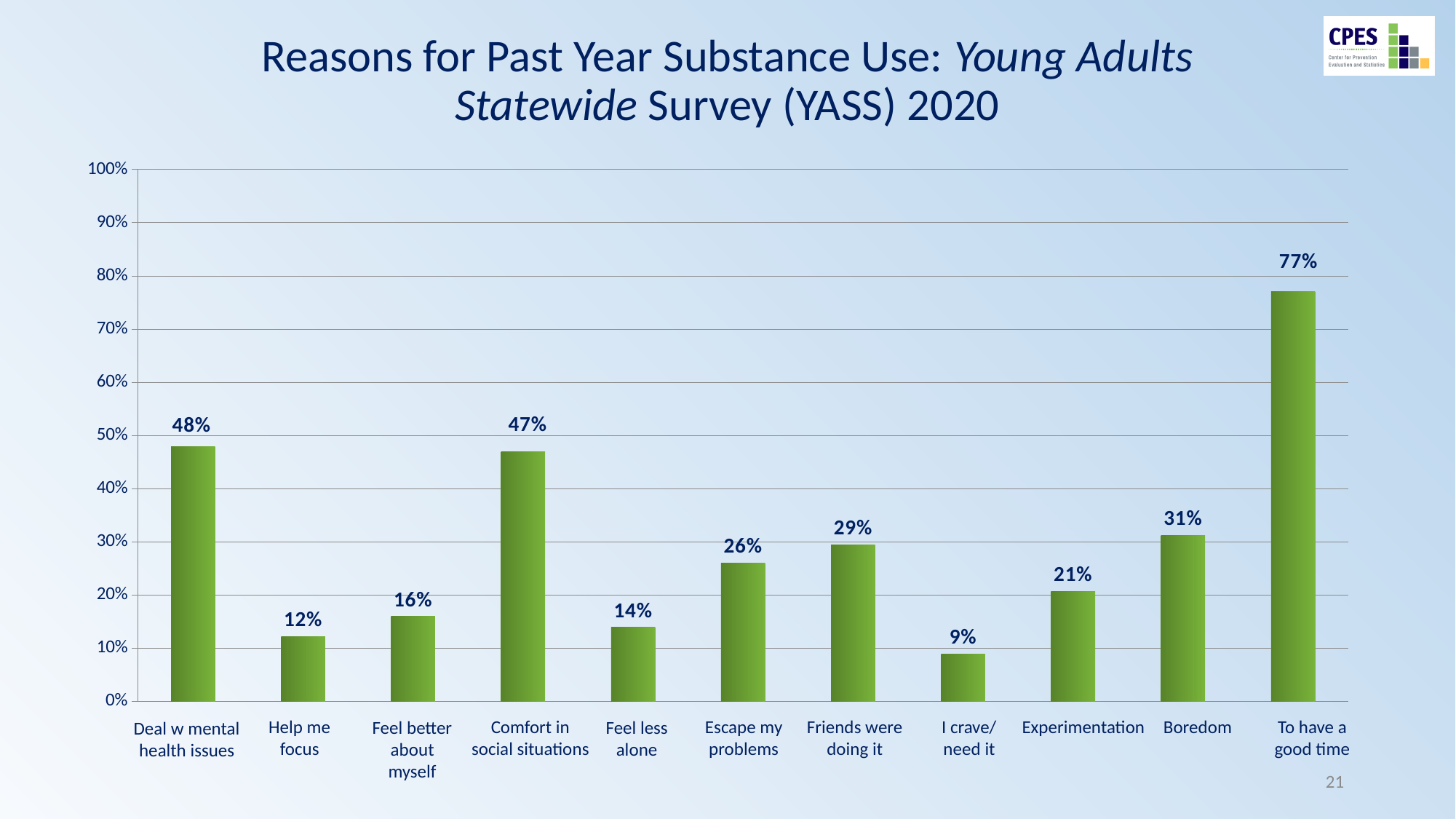
How many reasons (categories) are shown on the chart? 11 Which is larger: 'Escape my problems' or 'Friends were doing it'? Friends were doing it What is the difference between 'To have a good time' and 'Boredom'? 46% What is the value for 'Deal w mental health issues'? 48% What percentage of young adults reported using substances to have a good time? 77% Which reason has the highest percentage? To have a good time Is the value for 'Comfort in social situations' greater or less than 40%? greater What is the difference between 'Feel better about myself' and 'Help me focus'? 4% What percentage is shown for 'Experimentation'? 21% What kind of chart is shown on the slide? Bar chart Which reason has the lowest percentage? I crave/ need it What is the maximum value shown on the vertical axis? 100%